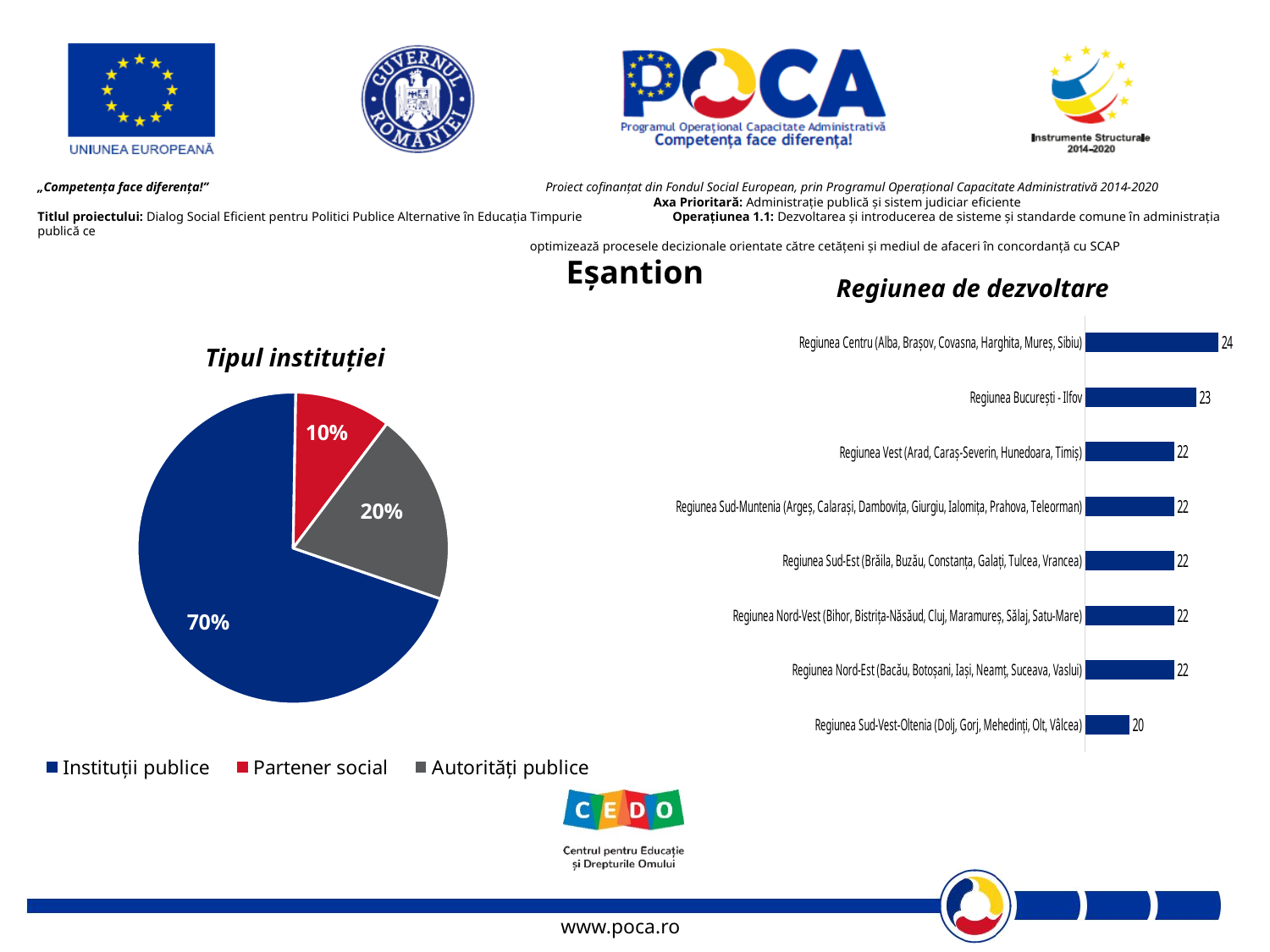
In the 'Regiunea de dezvoltare' chart, what is the difference between Regiunea Centru and Regiunea București - Ilfov? 1 In the 'Regiunea de dezvoltare' chart, which region has the highest value? Regiunea Centru In the 'Tipul instituției' chart, how many categories does the legend list? 3 In the 'Tipul instituției' chart, what share of the pie is Instituții publice? 70% In the 'Regiunea de dezvoltare' chart, what is the value for Regiunea Sud-Vest-Oltenia? 20 In the 'Tipul instituției' chart, what share of the pie is Autorități publice? 20% In the 'Tipul instituției' chart, which category has the smallest slice? Partener social In the 'Regiunea de dezvoltare' chart, how many regions are shown? 8 What kind of chart is 'Tipul instituției'? Pie chart In the 'Tipul instituției' chart, what share of the pie is Partener social? 10% In the 'Regiunea de dezvoltare' chart, what is the value for Regiunea Centru? 24 In the 'Tipul instituției' chart, which category has the largest slice? Instituții publice